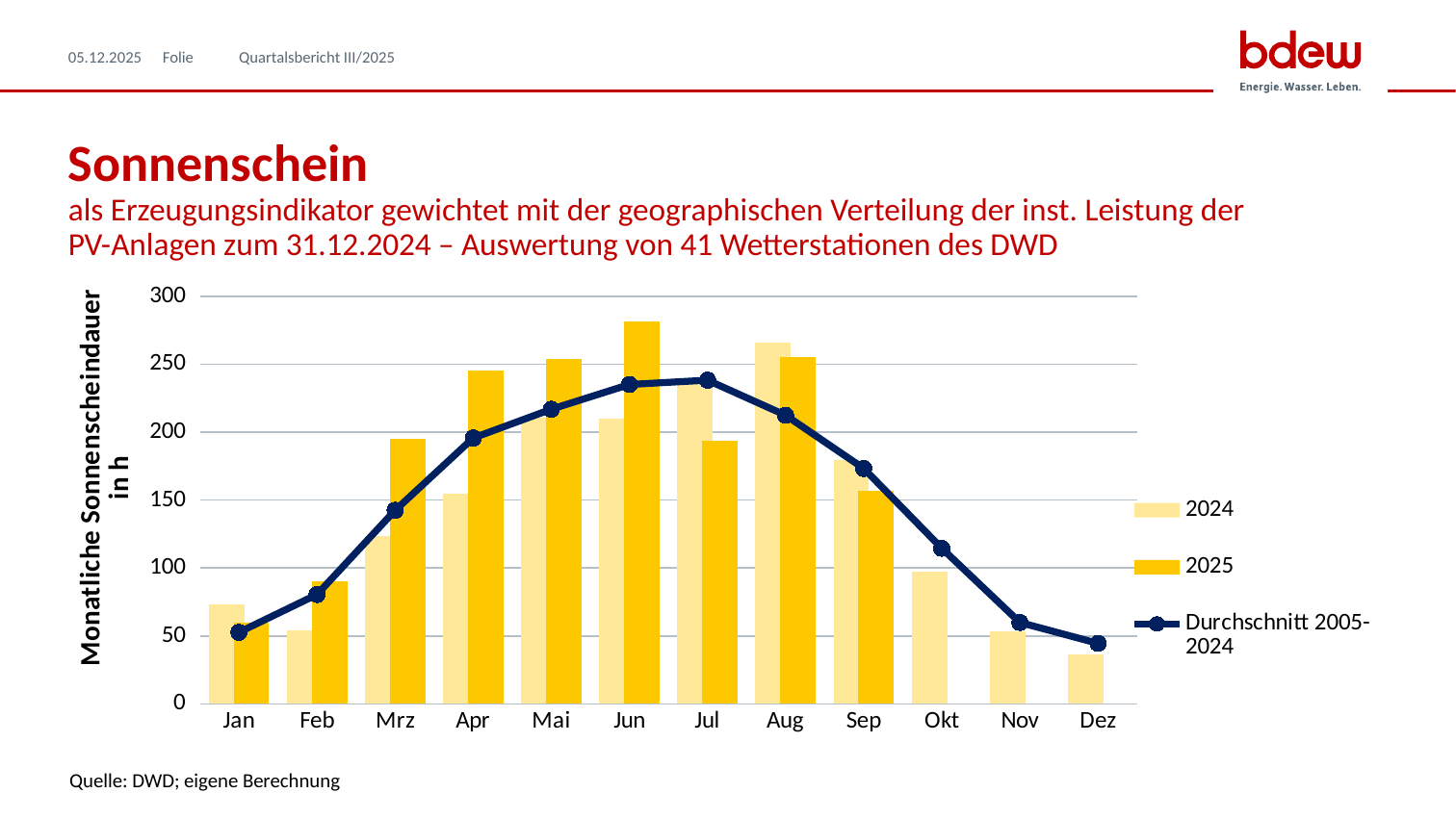
Is the 2025 value for Jun greater or less than 250? greater Is the 2024 value for Dez greater or less than 50? less How many months are shown on the x axis? 12 How many series does the legend list? 3 Is the 2025 value for Mrz greater or less than 150? greater In which month is the 2024 bar highest? Aug In Jul, which is larger: the 2024 bar or the 2025 bar? 2024 In which month is the 2025 bar highest? Jun For how many months is a 2025 bar plotted? 9 What kind of chart is shown on the slide? bar chart with a line In which month is the 2024 bar lowest? Dez In Apr, which is larger: the 2024 bar or the 2025 bar? 2025